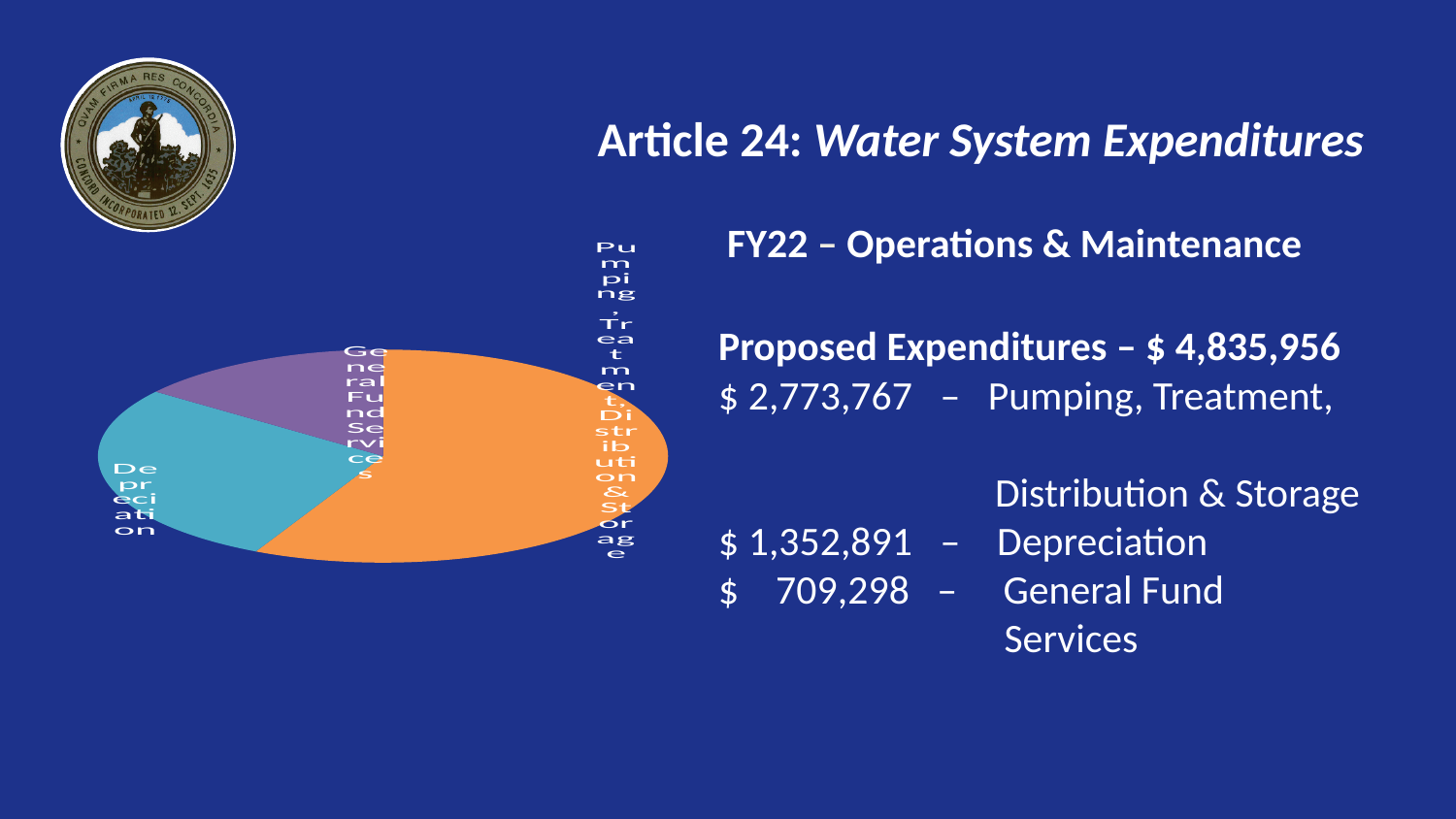
How many slices does the pie chart have? 3 What colour is the Depreciation slice of the pie chart? teal According to the slide, what is the proposed expenditure for Pumping, Treatment, Distribution & Storage? $ 2,773,767 What kind of chart is shown on the slide? pie chart What colour is the General Fund Services slice of the pie chart? purple According to the slide, what is the proposed expenditure for Depreciation? $ 1,352,891 Which slice is larger, Pumping, Treatment, Distribution & Storage or Depreciation? Pumping, Treatment, Distribution & Storage According to the slide, what is the proposed expenditure for General Fund Services? $ 709,298 Which slice is larger, Depreciation or General Fund Services? Depreciation Which category has the smallest slice of the pie chart? General Fund Services Which category has the largest slice of the pie chart? Pumping, Treatment, Distribution & Storage What is the total of the proposed expenditures shown on the slide? $ 4,835,956